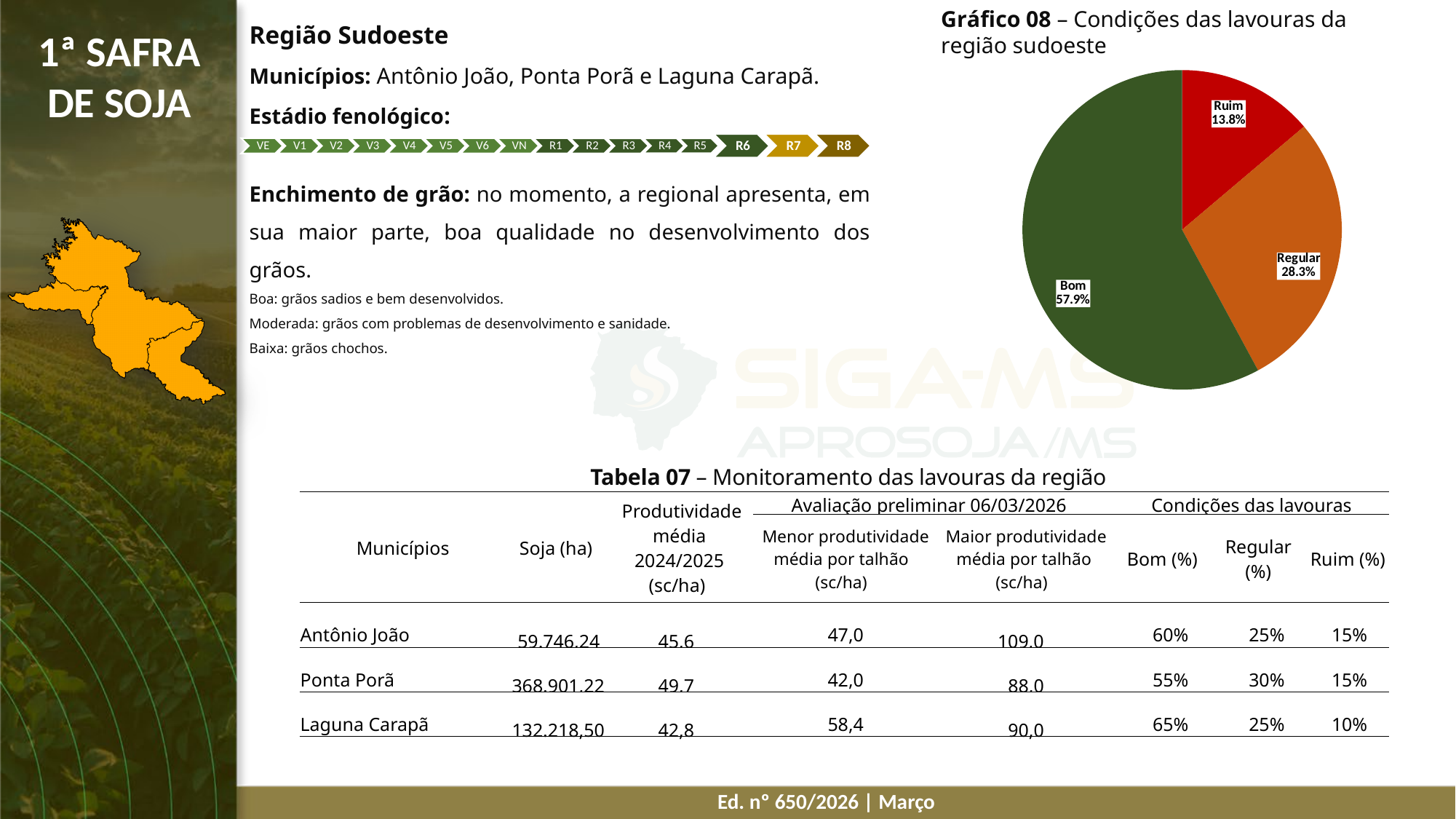
In Gráfico 08, what is the difference in percentage points between the Regular and Ruim slices? 14.5 In Gráfico 08, which category has the largest slice? Bom In Gráfico 08, what colour is the Bom slice? dark green What is the title of the pie chart on the slide? Gráfico 08 – Condições das lavouras da região sudoeste In Gráfico 08, what share of the pie is labelled Bom? 57.9% In Gráfico 08, what share of the pie is labelled Regular? 28.3% In Gráfico 08, what share of the pie is labelled Ruim? 13.8% In Gráfico 08, which category has the smallest slice? Ruim In Gráfico 08, which slice is larger, Regular or Ruim? Regular In Gráfico 08, how many slices does the pie have? 3 In Gráfico 08, what is the difference in percentage points between the Bom and Regular slices? 29.6 What kind of chart is Gráfico 08? pie chart